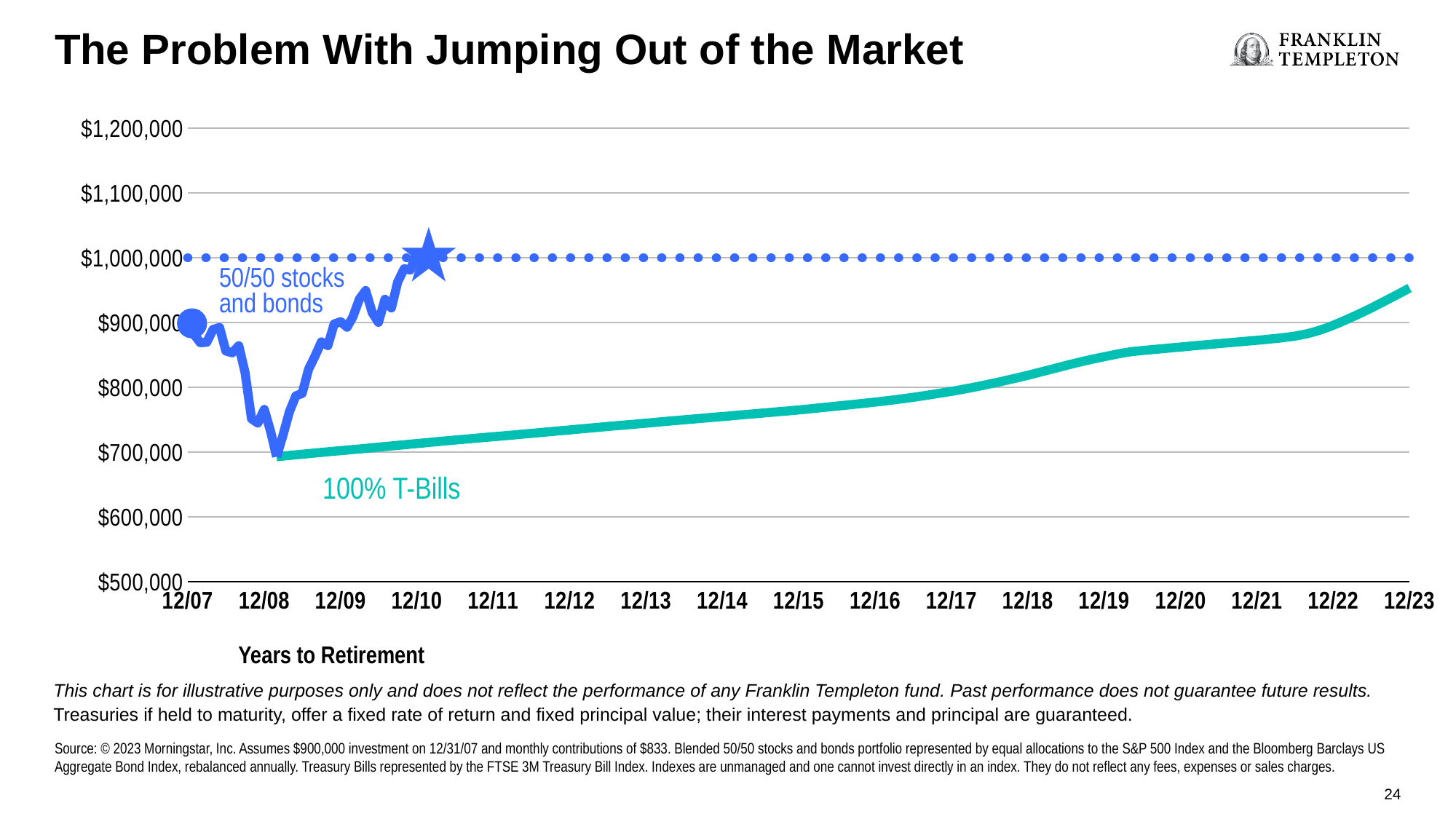
How many date labels are shown along the x axis? 17 At what value is the horizontal dotted line drawn? $1,000,000 Is the value of the 100% T-Bills line at 12/23 greater or less than $1,000,000? less What are the two series labelled on the chart? 50/50 stocks and bonds; 100% T-Bills At 12/09, which line is higher: 50/50 stocks and bonds or 100% T-Bills? 50/50 stocks and bonds What kind of chart is shown on the slide? line chart What is the starting value of the 50/50 stocks and bonds line at 12/07? $900,000 Is the value of the 100% T-Bills line at 12/15 greater or less than $800,000? less Is the value of the 50/50 stocks and bonds line at 12/10 greater or less than $900,000? greater What is the title of the slide's chart? The Problem With Jumping Out of the Market Does the 100% T-Bills line rise or fall from 12/08 to 12/23? rises What is the label of the x axis? Years to Retirement